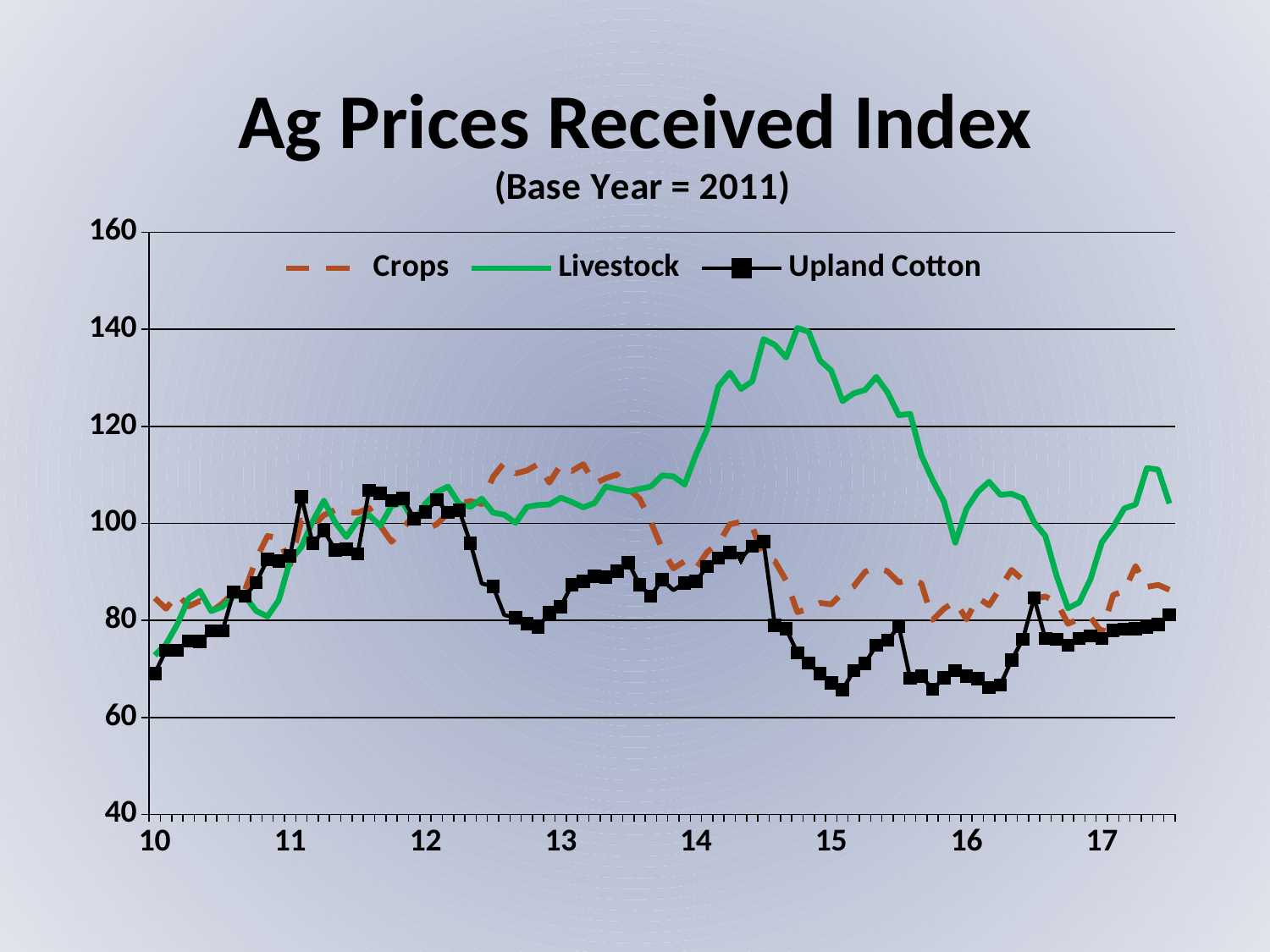
At 15, which is larger: Livestock or Upland Cotton? Livestock Which series reaches the highest value anywhere on the chart? Livestock What kind of chart is shown on the slide? line chart Is the value for Livestock at 15 greater or less than 120? greater What base year does the subtitle give for the index? 2011 What is the title of the chart? Ag Prices Received Index Is the value for Upland Cotton at 15 greater or less than 80? less Is the value for Crops at 16 greater or less than 100? less How many series does the legend list? 3 Does the Upland Cotton line rise or fall between 14.5 and 15? fall Which series reaches the lowest value anywhere on the chart? Upland Cotton